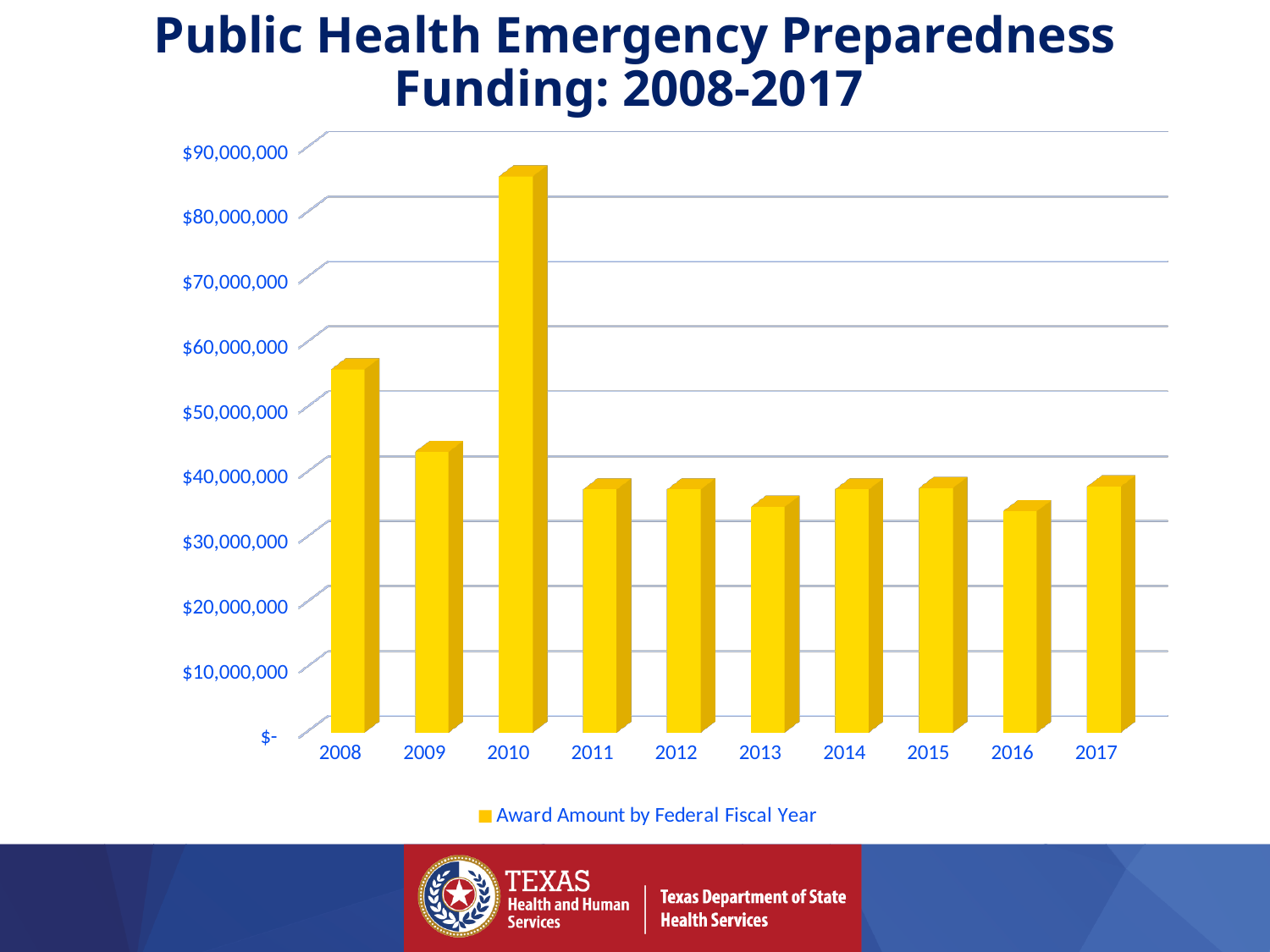
How many series does the legend list? 1 Which year has the larger award amount, 2008 or 2009? 2008 Is the value for 2016 greater or less than $30,000,000? greater Is the value for 2009 greater or less than $40,000,000? greater Does the award amount rise or fall from 2010 to 2011? fall What kind of chart is shown on the slide? bar chart Is the value for 2008 greater or less than $50,000,000? greater How many years are shown on the x axis of the chart? 10 Which year has the highest award amount? 2010 What is the legend entry for the series shown in the chart? Award Amount by Federal Fiscal Year